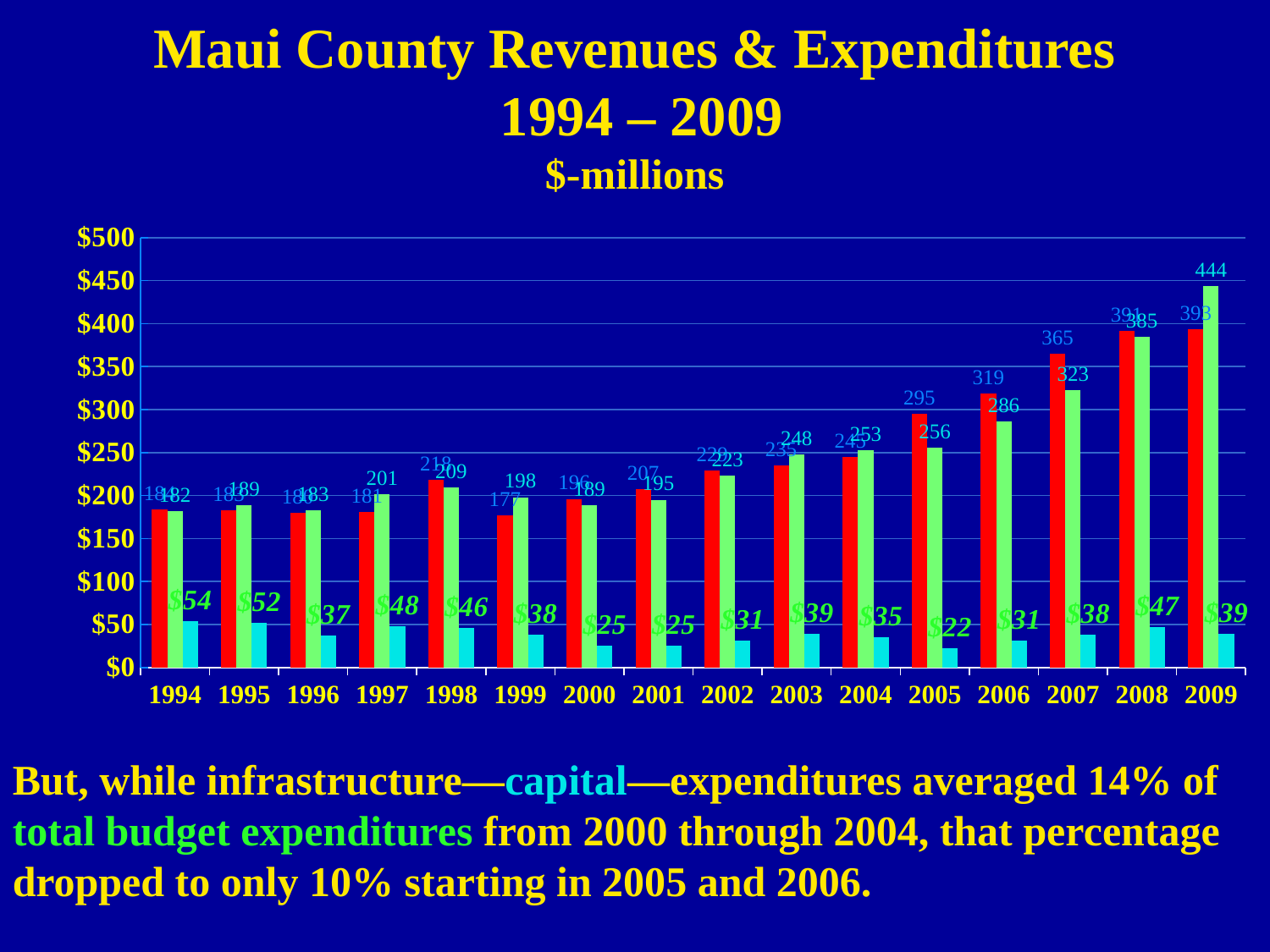
How many years are shown along the x axis of the chart? 16 What is the value of the cyan (capital) bar for 1994? $54 In which year is the cyan (capital) bar highest? 1994 What is the value of the red bar for 2007? 365 What is the value of the green bar for 2009? 444 Do the green bars generally rise or fall from 1994 to 2009? rise In which year is the cyan (capital) bar lowest? 2005 Is the value of the red bar for 2009 greater or less than $350? greater What is the difference between the green bar for 2009 (444) and the green bar for 2008 (385)? 59 What kind of chart is shown on the slide? bar chart What is the value of the cyan (capital) bar for 2005? $22 For 2009, which is larger: the red bar or the green bar? the green bar